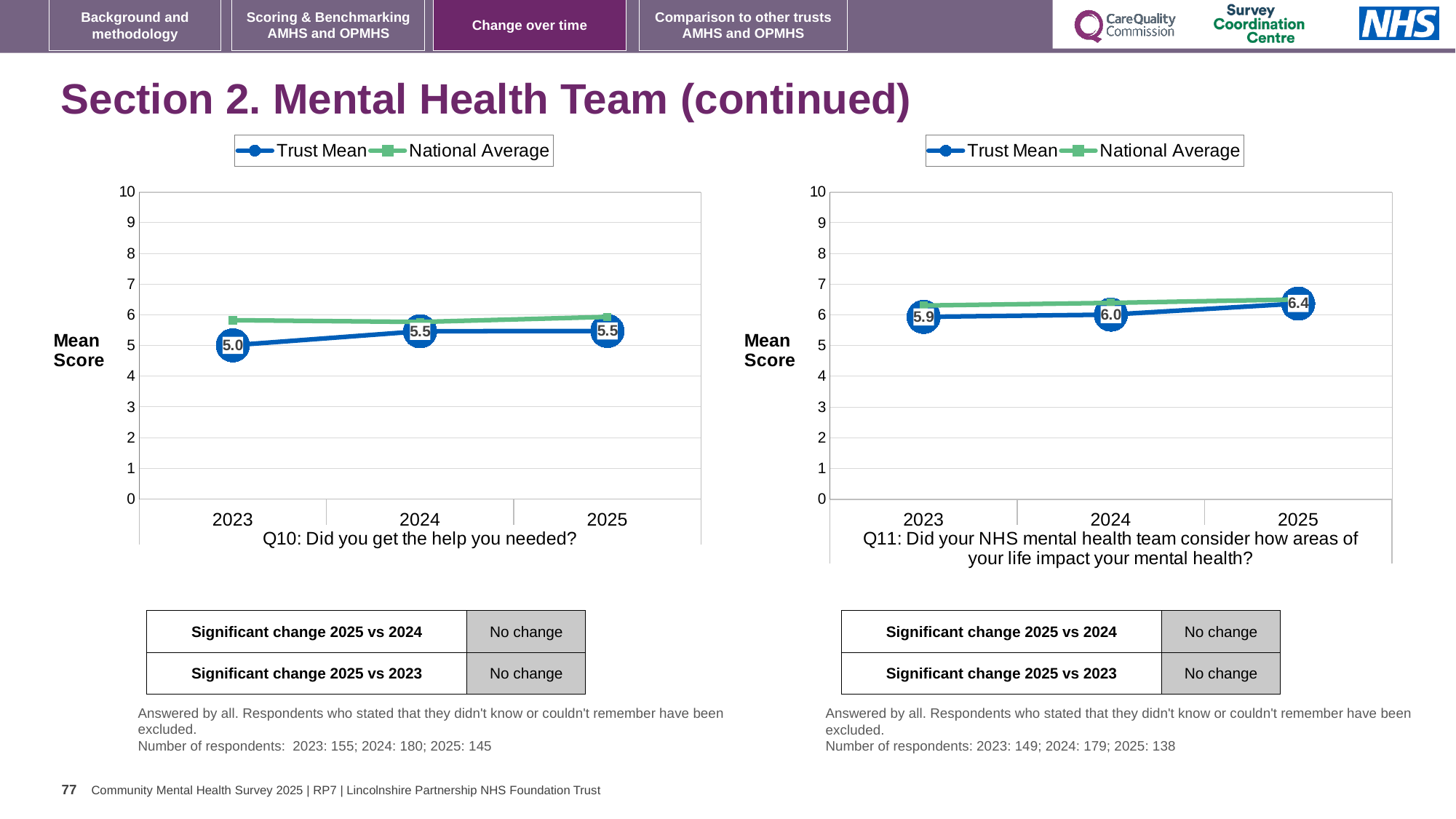
In the Q11 chart, what is the Trust Mean for 2023? 5.9 In the Q10 chart, what is the Trust Mean for 2025? 5.5 How many series does the legend of the Q11 chart list? 2 In the Q10 chart, which year has the lowest Trust Mean? 2023 In the Q11 chart, what is the difference between the Trust Mean for 2025 and the Trust Mean for 2023? 0.5 In the Q10 chart, is the National Average for 2023 greater or less than 5? greater In the Q10 chart, what is the difference between the Trust Mean for 2025 and the Trust Mean for 2023? 0.5 In the Q11 chart, what is the Trust Mean for 2025? 6.4 In the Q10 chart, what is the Trust Mean for 2023? 5.0 In the Q11 chart, which year has the highest Trust Mean? 2025 What type of chart is the Q10 chart? Line chart In the Q10 chart, is the Trust Mean or the National Average higher in 2023? National Average